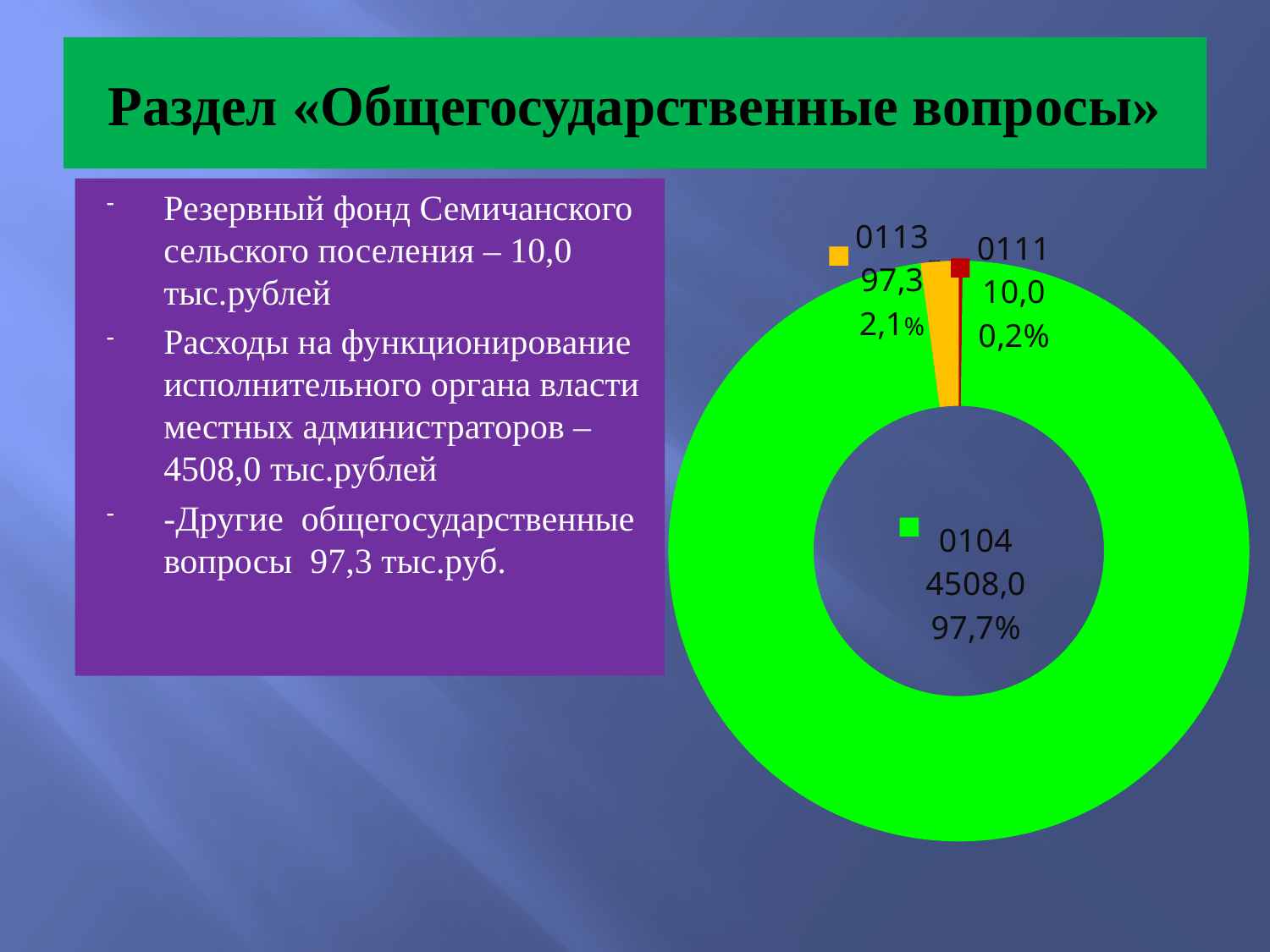
What value is shown for category 0104 on the chart? 4508,0 Which category has the largest slice in the chart? 0104 Which category has the smallest slice in the chart? 0111 Which is larger, the value for 0113 or the value for 0111? 0113 What value is shown for category 0111 on the chart? 10,0 What is the difference between the values for 0104 and 0113? 4410,7 What share of the chart does category 0113 represent? 2,1% What type of chart is shown on the slide? doughnut chart How many categories are shown in the chart? 3 What share of the chart does category 0111 represent? 0,2% What value is shown for category 0113 on the chart? 97,3 What share of the chart does category 0104 represent? 97,7%